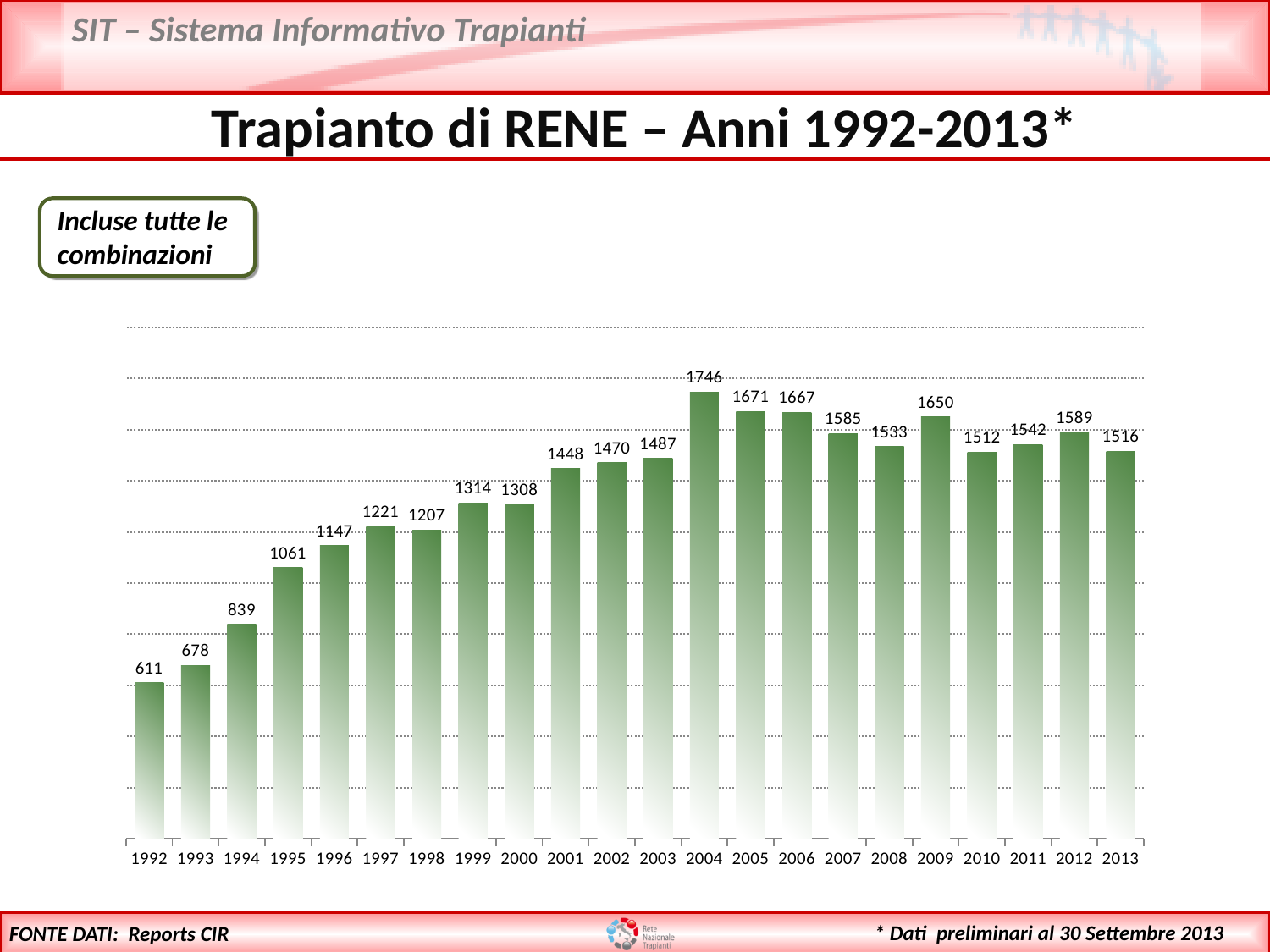
What is the value for 1992? 611 What is the value for 2004? 1746 Which year has the highest value? 2004 Which year has the lowest value? 1992 What kind of chart is shown on the slide? Bar chart Which is larger, the value for 2009 or the value for 2008? 2009 What is the value for 1999? 1314 What is the value for 2013? 1516 What is the difference between the values for 2012 and 2013? 73 Do the values rise or fall from 1992 to 2004? Rise How many years are shown on the x axis? 22 What is the difference between the values for 2004 and 1992? 1135